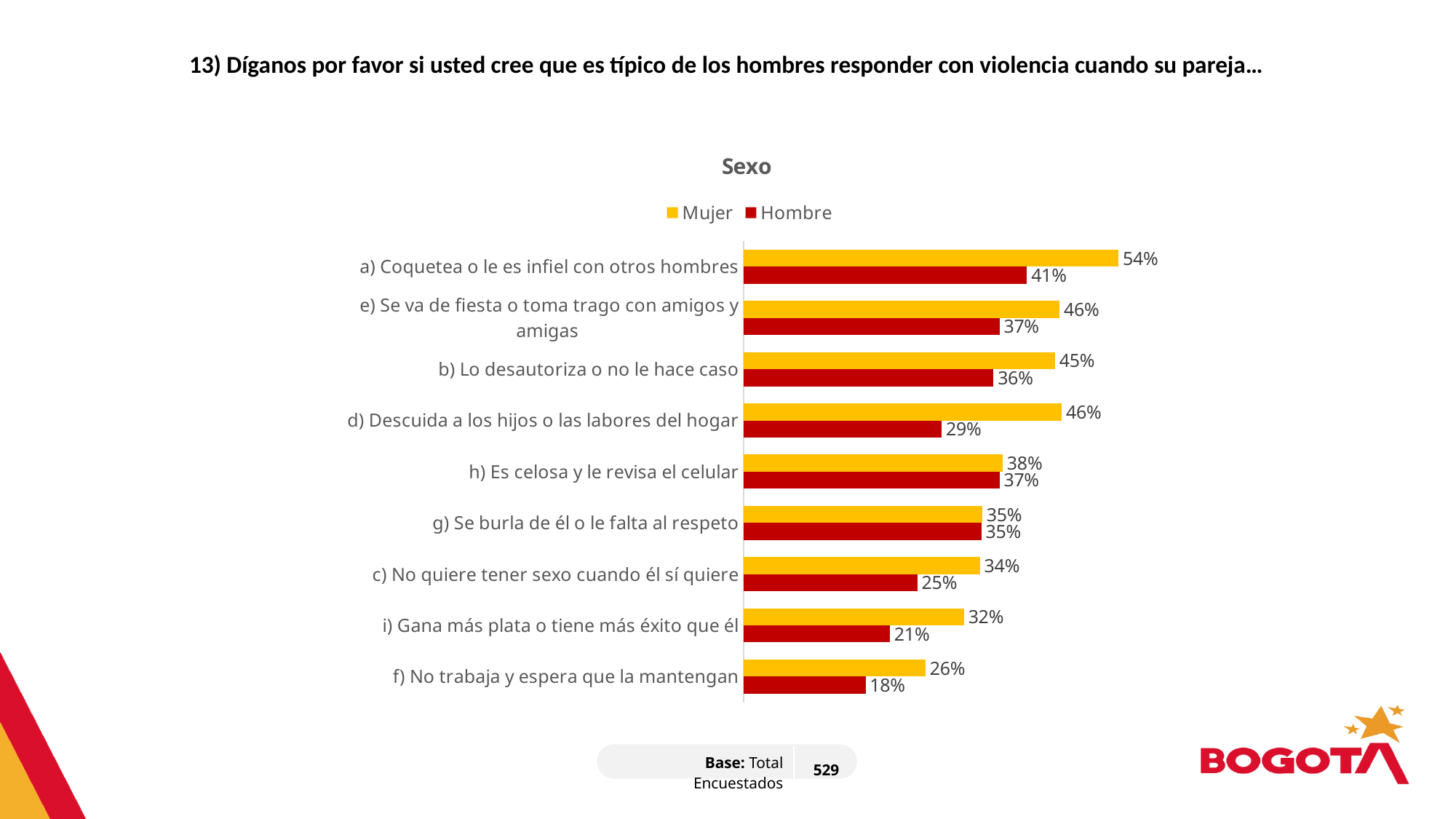
What is the Mujer value for "a) Coquetea o le es infiel con otros hombres"? 54% What is the difference between the Mujer and Hombre values for "c) No quiere tener sexo cuando él sí quiere"? 9% How many series does the legend list? 2 How many categories are shown in the chart? 9 What is the Hombre value for "d) Descuida a los hijos o las labores del hogar"? 29% Which category has the lowest Hombre value? f) No trabaja y espera que la mantengan What is the title of the chart? Sexo Which is larger for "i) Gana más plata o tiene más éxito que él": the Mujer value or the Hombre value? Mujer What kind of chart is shown on the slide? Bar chart Which category has the highest Mujer value? a) Coquetea o le es infiel con otros hombres What is the Hombre value for "f) No trabaja y espera que la mantengan"? 18% Which colour represents the Hombre series? Red